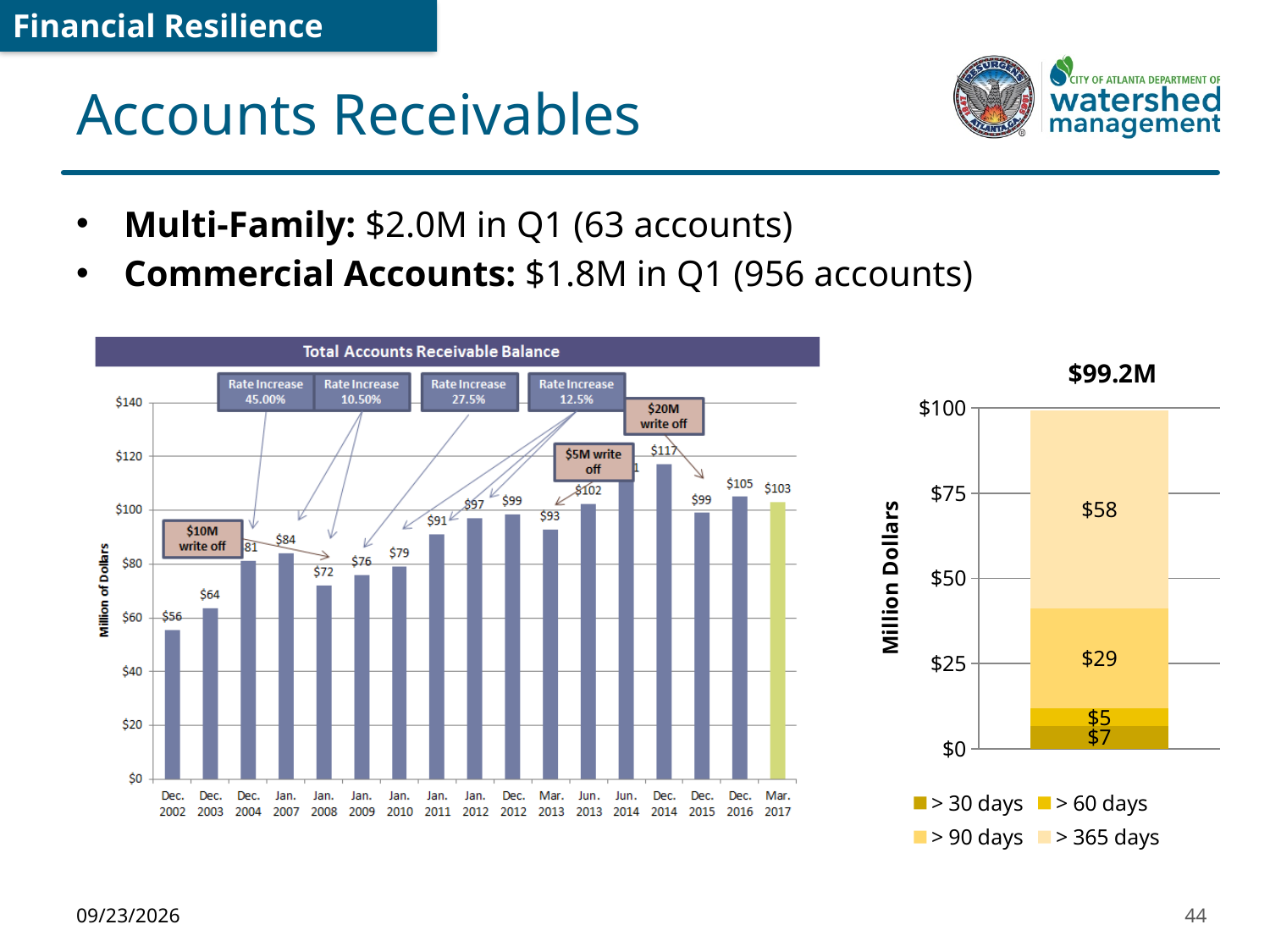
In the Total Accounts Receivable Balance chart, which is larger, the value for Jan. 2010 or the value for Jan. 2011? Jan. 2011 In the Total Accounts Receivable Balance chart, what is the difference between the Dec. 2016 and Dec. 2015 values? $6 In the Total Accounts Receivable Balance chart, what is the value for Jan. 2008? $72 In the stacked bar chart on the right, how many series does the legend list? 4 In the stacked bar chart on the right, what total is shown above the stacked bar? $99.2M What kind of chart is the Total Accounts Receivable Balance chart? bar chart In the Total Accounts Receivable Balance chart, what is the value for Dec. 2002? $56 In the Total Accounts Receivable Balance chart, which period has the lowest balance? Dec. 2002 In the Total Accounts Receivable Balance chart, which period has the highest balance? Dec. 2014 In the Total Accounts Receivable Balance chart, is the value for Dec. 2003 greater or less than $80? less In the stacked bar chart on the right, what is the value for the > 365 days segment? $58 In the Total Accounts Receivable Balance chart, what is the value for Mar. 2017? $103